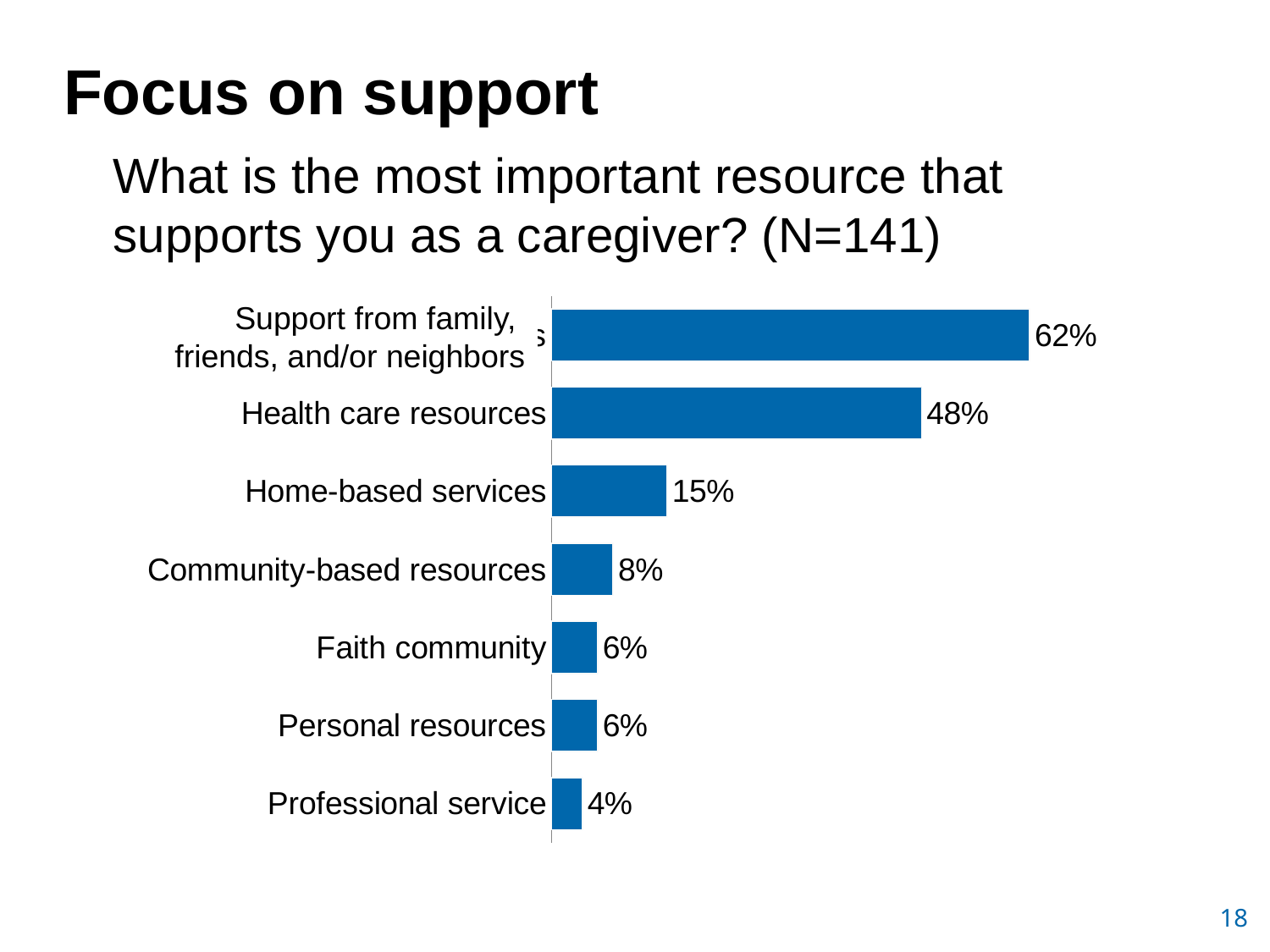
Which resource has the lowest percentage? Professional service Which is larger, Health care resources or Home-based services? Health care resources What is the sample size (N) stated in the question above the chart? 141 What is the value for Professional service? 4% What type of chart is shown on the slide? Bar chart What percentage is shown for Community-based resources? 8% How many resource categories are shown in the chart? 7 Which resource has the highest percentage? Support from family, friends, and/or neighbors What is the difference in percentage points between Support from family, friends, and/or neighbors and Health care resources? 14 percentage points What is the value shown for Home-based services? 15% What is the difference between Home-based services and Community-based resources? 7 percentage points What percentage of caregivers chose Health care resources as the most important resource? 48%